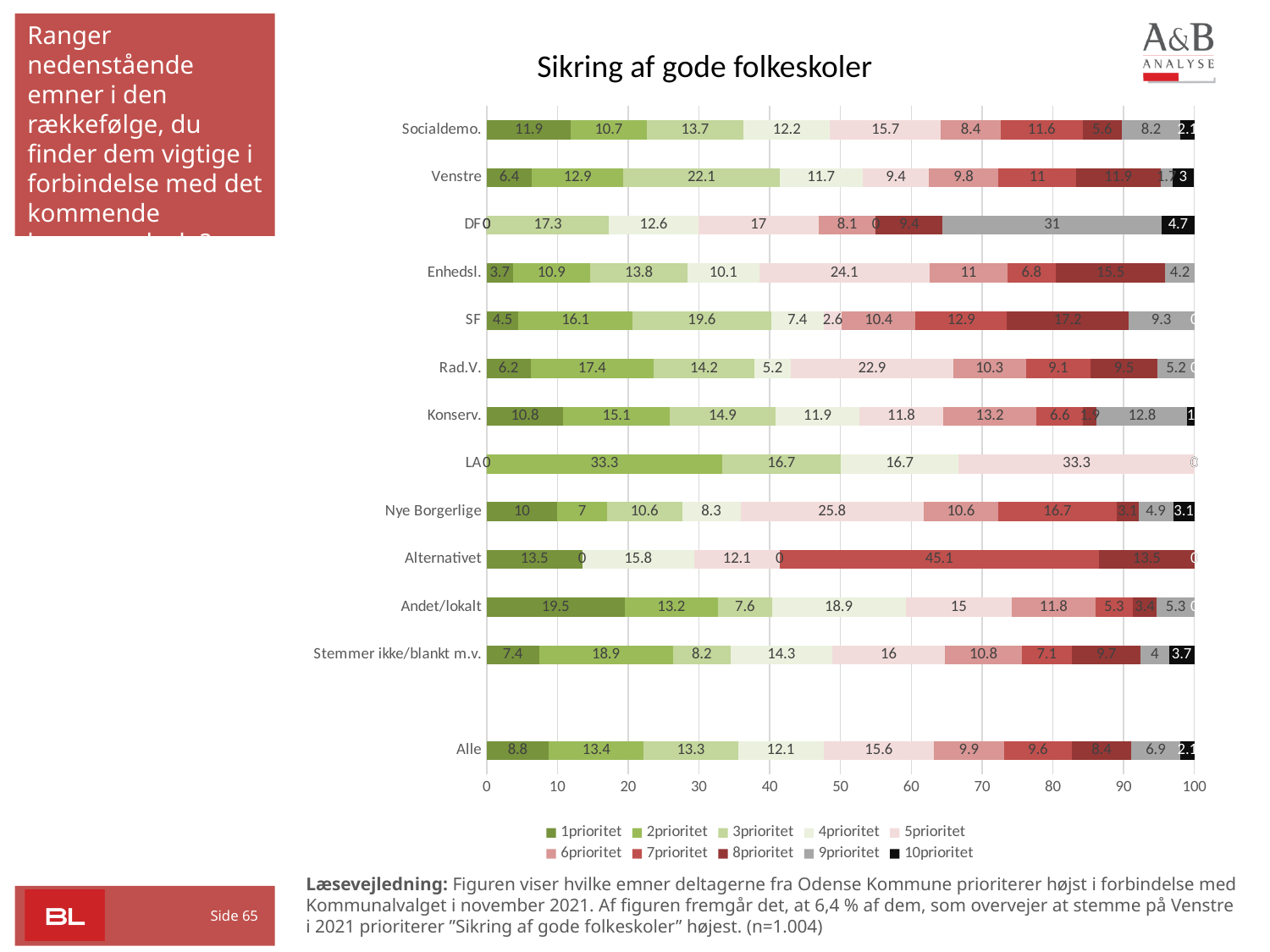
What is the 5prioritet value for Alle? 15.6 What is the 1prioritet value for Andet/lokalt? 19.5 What is the 7prioritet value for Alternativet? 45.1 What is the 3prioritet value for Venstre? 22.1 What type of chart is shown on the slide? bar chart Which has the larger 2prioritet value, Venstre or Socialdemo.? Venstre What is the title of the chart? Sikring af gode folkeskoler How many series does the legend list? 10 Which category has the highest 1prioritet value? Andet/lokalt What is the 1prioritet value for Venstre? 6.4 What is the difference between the 1prioritet value for Socialdemo. and the 1prioritet value for Alle? 3.1 How many categories (voter groups) are shown on the y axis? 13